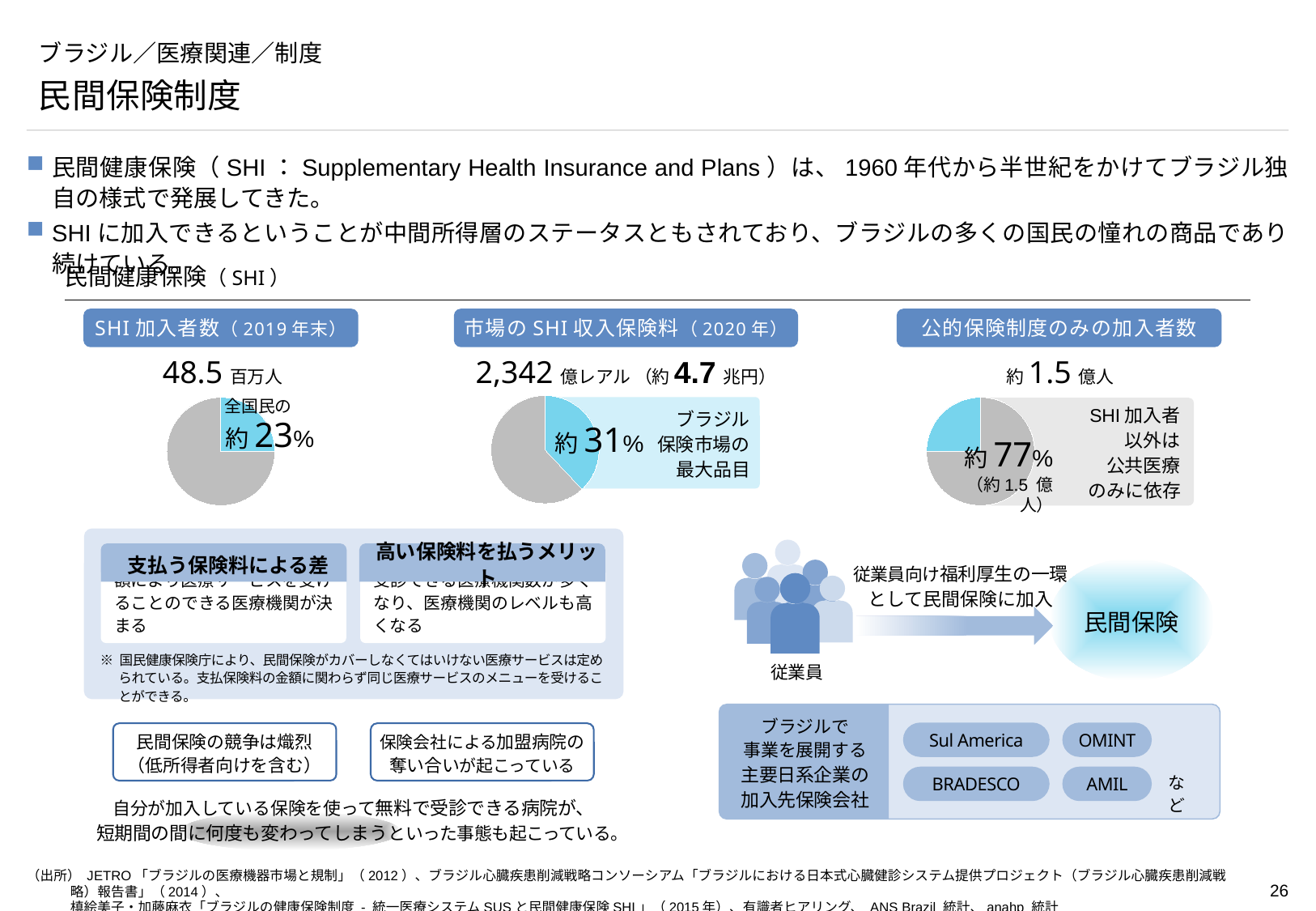
What headline figure is printed above the pie chart under 'SHI 加入者数（2019 年末）'? 48.5 百万人 Of the three pie charts on the slide, which one shows the largest percentage? 公的保険制度のみの加入者数 How many pie charts are shown on the slide? 3 What kind of chart is shown under the heading 'SHI 加入者数（2019 年末）'? pie chart What headline figure in レアル is printed above the pie chart under '市場の SHI 収入保険料（2020 年）'? 2,342 億レアル Of the three pie charts on the slide, which one shows the smallest percentage? SHI 加入者数（2019 年末） In the pie chart under 'SHI 加入者数（2019 年末）', is the highlighted share greater or less than 50%? less In the pie chart under '公的保険制度のみの加入者数', what percentage is printed on the chart? 約 77% In the pie chart under 'SHI 加入者数（2019 年末）', what share of 全国民 does the highlighted slice show? 約 23% In the pie chart under '市場の SHI 収入保険料（2020 年）', what percentage is printed on the highlighted slice? 約 31%